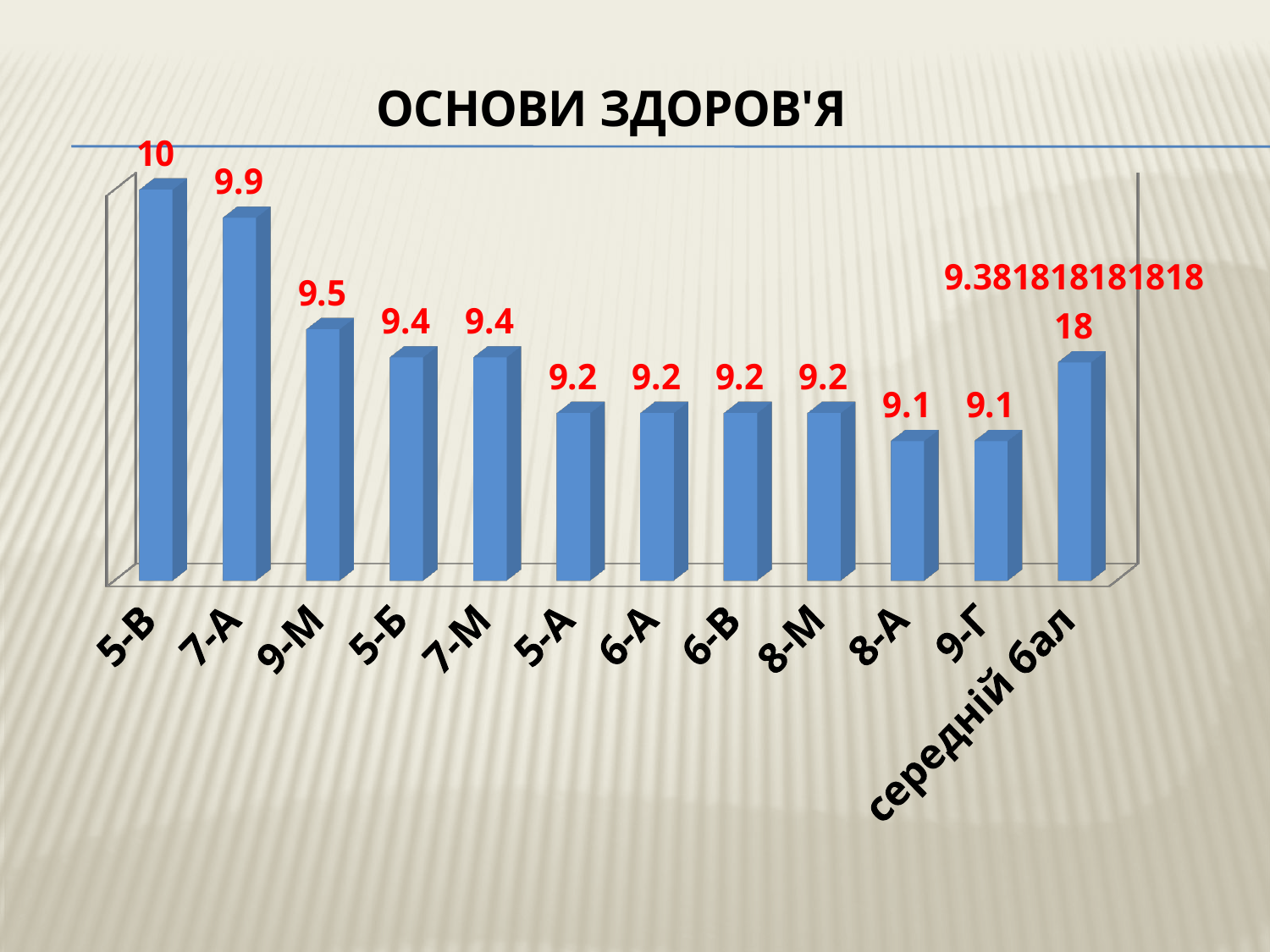
What is the value for 6-В? 9.2 What is the value for 7-А? 9.9 What is the value for 8-А? 9.1 What is the difference between the values for 5-В and 9-М? 0.5 What is the difference between the values for 7-А and 8-А? 0.8 What is the value for 9-М? 9.5 What is the value for 5-В? 10 What is the title of the chart? ОСНОВИ ЗДОРОВ'Я How many bars are shown in the chart? 12 Which is larger, the value for 9-М or the value for 5-Б? 9-М What kind of chart is shown on the slide? bar chart Which category has the highest value? 5-В